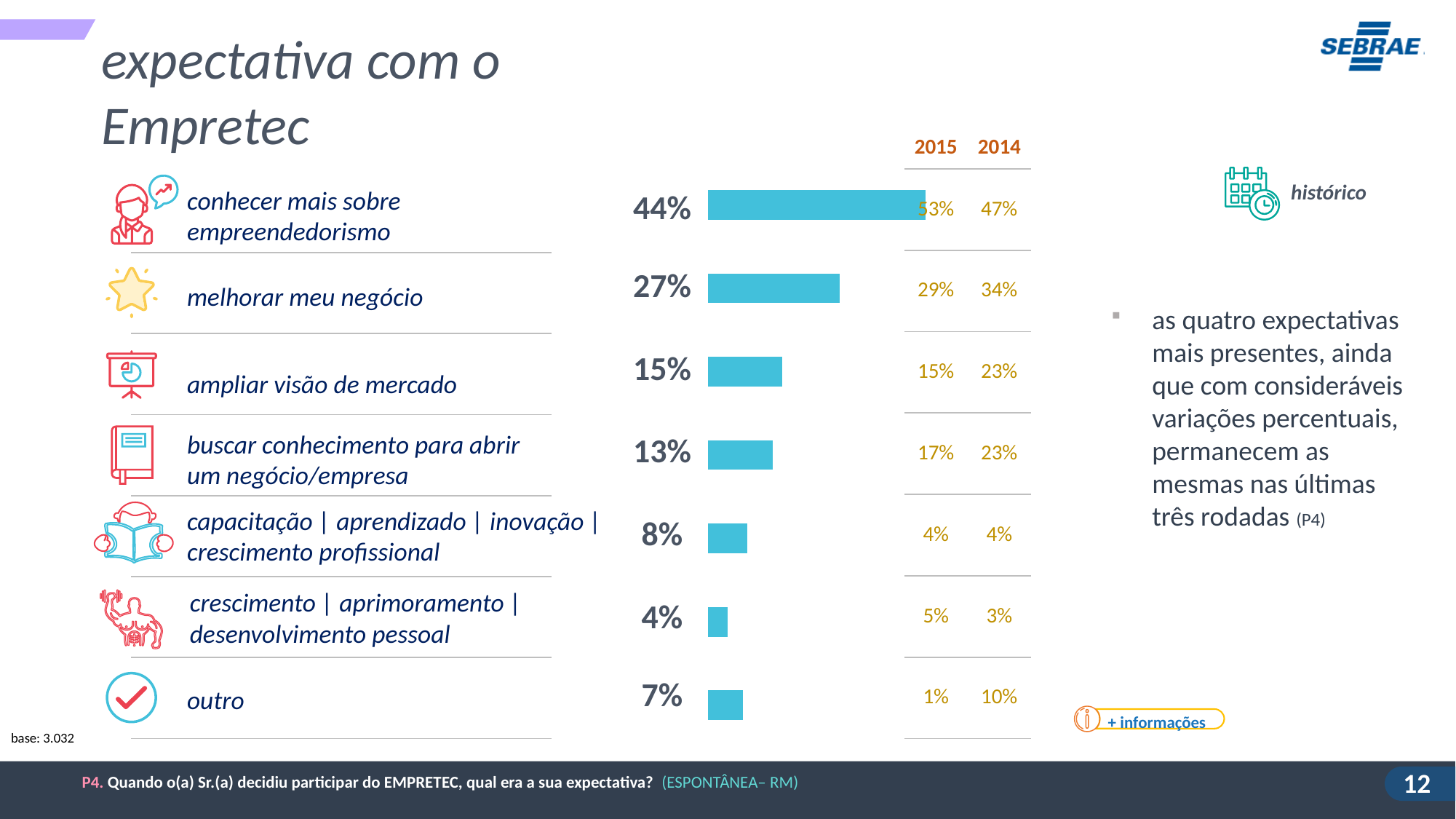
What was the 2014 value for "outro" in the historical columns? 10% What is the difference between the values for "conhecer mais sobre empreendedorismo" and "melhorar meu negócio"? 17% Which category has the lowest value? crescimento | aprimoramento | desenvolvimento pessoal What is the value for "outro"? 7% What is the base (sample size) shown on the slide? 3.032 What was the 2015 value for "melhorar meu negócio" in the historical columns? 29% Which is larger, the value for "ampliar visão de mercado" or the value for "buscar conhecimento para abrir um negócio/empresa"? ampliar visão de mercado How many categories are shown in the bar chart? 7 What kind of chart is shown on the slide? bar chart Which category has the highest value? conhecer mais sobre empreendedorismo What is the value for "melhorar meu negócio"? 27% What is the value for "conhecer mais sobre empreendedorismo"? 44%